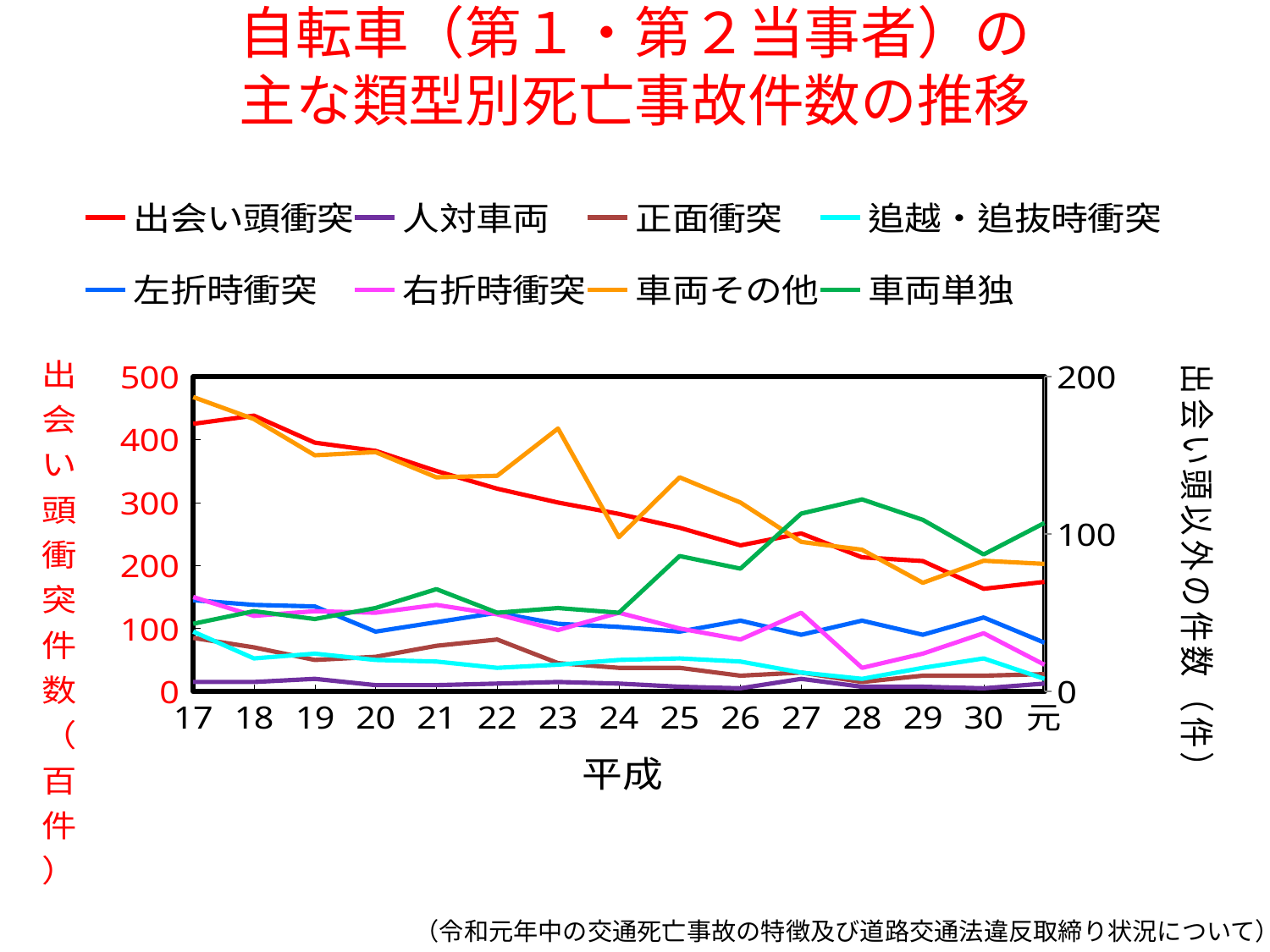
How many points are plotted along the x axis (from 17 to 元)? 15 At 28, which is larger: 車両単独 or 車両その他? 車両単独 How many series does the legend list? 8 Does the 車両単独 line rise or fall overall from 17 to 元? rise On the left axis, is the value for 出会い頭衝突 at 17 greater or less than 400? greater On the right axis, is the value for 人対車両 at 26 greater or less than 100? less What kind of chart is shown on the slide? line chart Does the 出会い頭衝突 line rise or fall overall from 17 to 元? fall What colour is the 出会い頭衝突 line in the legend? red On the left axis, is the value for 出会い頭衝突 at 元 greater or less than 200? less At 17, which is larger: 車両その他 or 車両単独? 車両その他